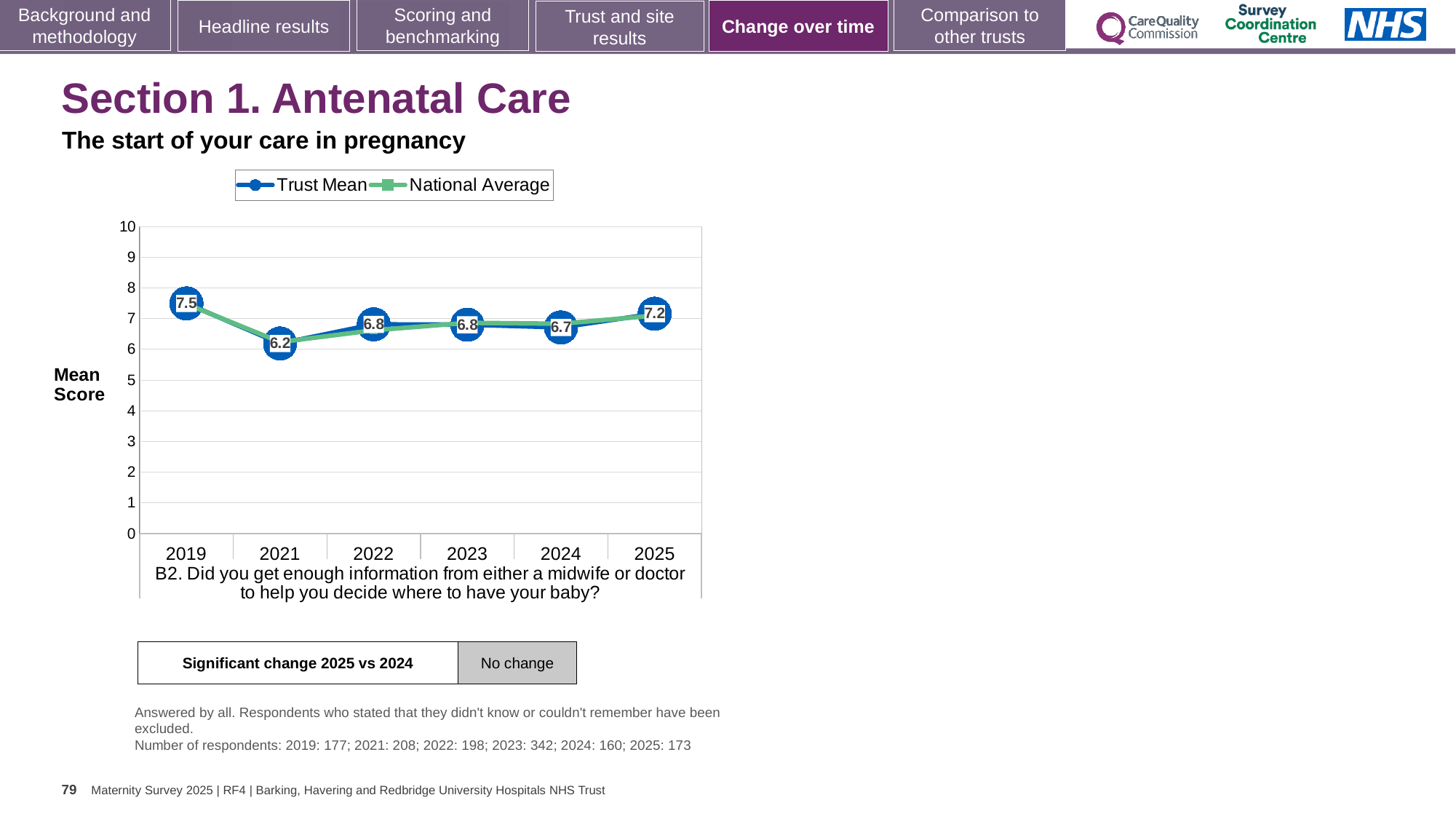
In which year is the Trust Mean score lowest? 2021 What kind of chart is shown on the slide? Line chart How many series does the legend list? 2 What is the Trust Mean score for 2024? 6.7 What is the Trust Mean score for 2025? 7.2 Is the National Average value for 2019 greater or less than 8? less How many years are plotted on the x axis? 6 Which year has a higher Trust Mean score, 2024 or 2025? 2025 In which year is the Trust Mean score highest? 2019 What is the Trust Mean score for 2019? 7.5 What is the difference between the Trust Mean score in 2019 and in 2021? 1.3 What is the Trust Mean score for 2021? 6.2